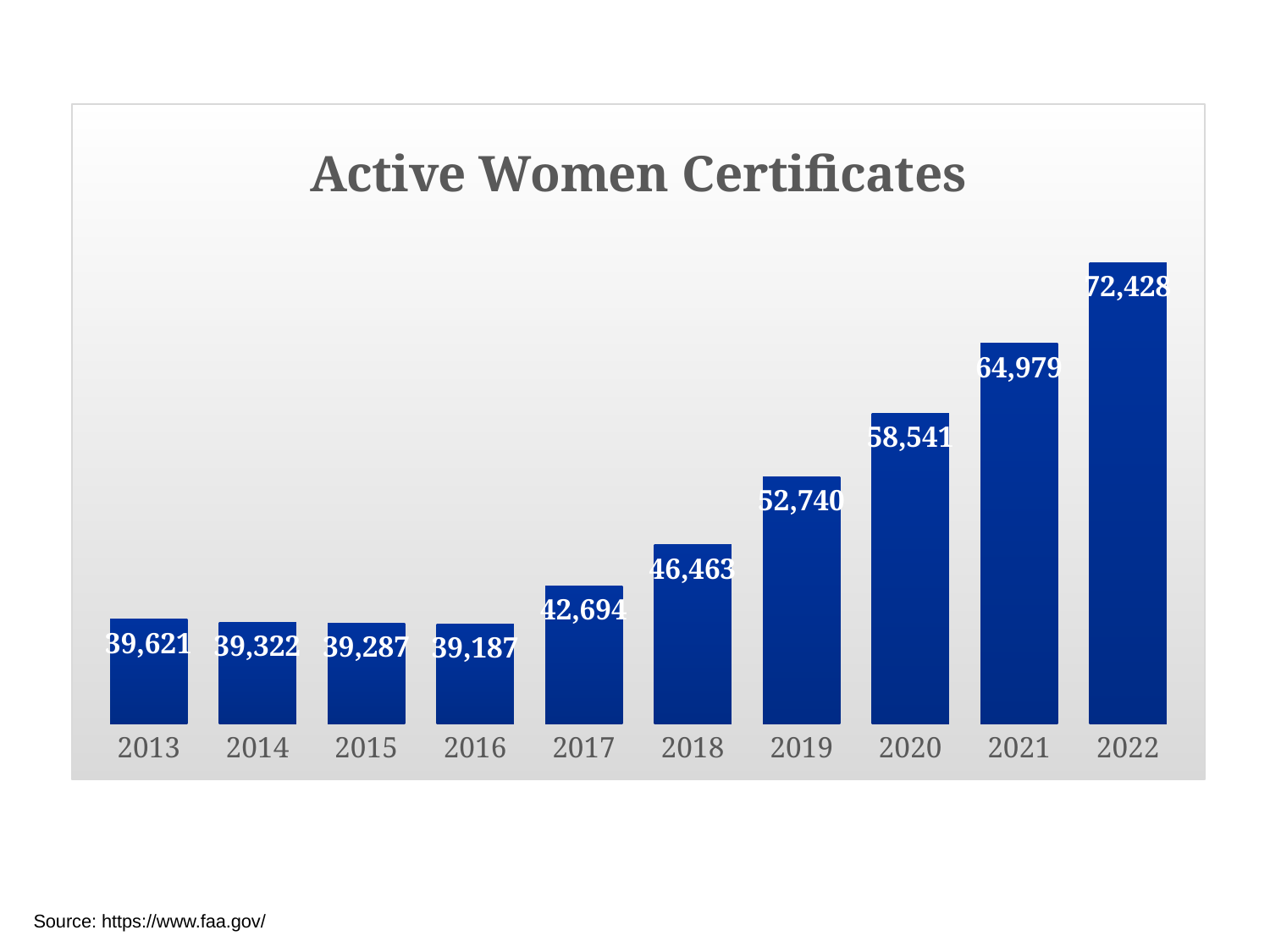
Which is larger, the value for 2014 or the value for 2018? 2018 What is the title of the chart? Active Women Certificates What is the value for 2022? 72,428 Do the values generally rise or fall from 2016 to 2022? Rise What is the value for 2017? 42,694 Which year has the highest value? 2022 How many years are shown on the x axis of the chart? 10 Which year has the lowest value? 2016 What is the value for 2020? 58,541 What is the difference between the values for 2022 and 2021? 7,449 What type of chart is shown on the slide? Bar chart What is the difference between the values for 2019 and 2018? 6,277